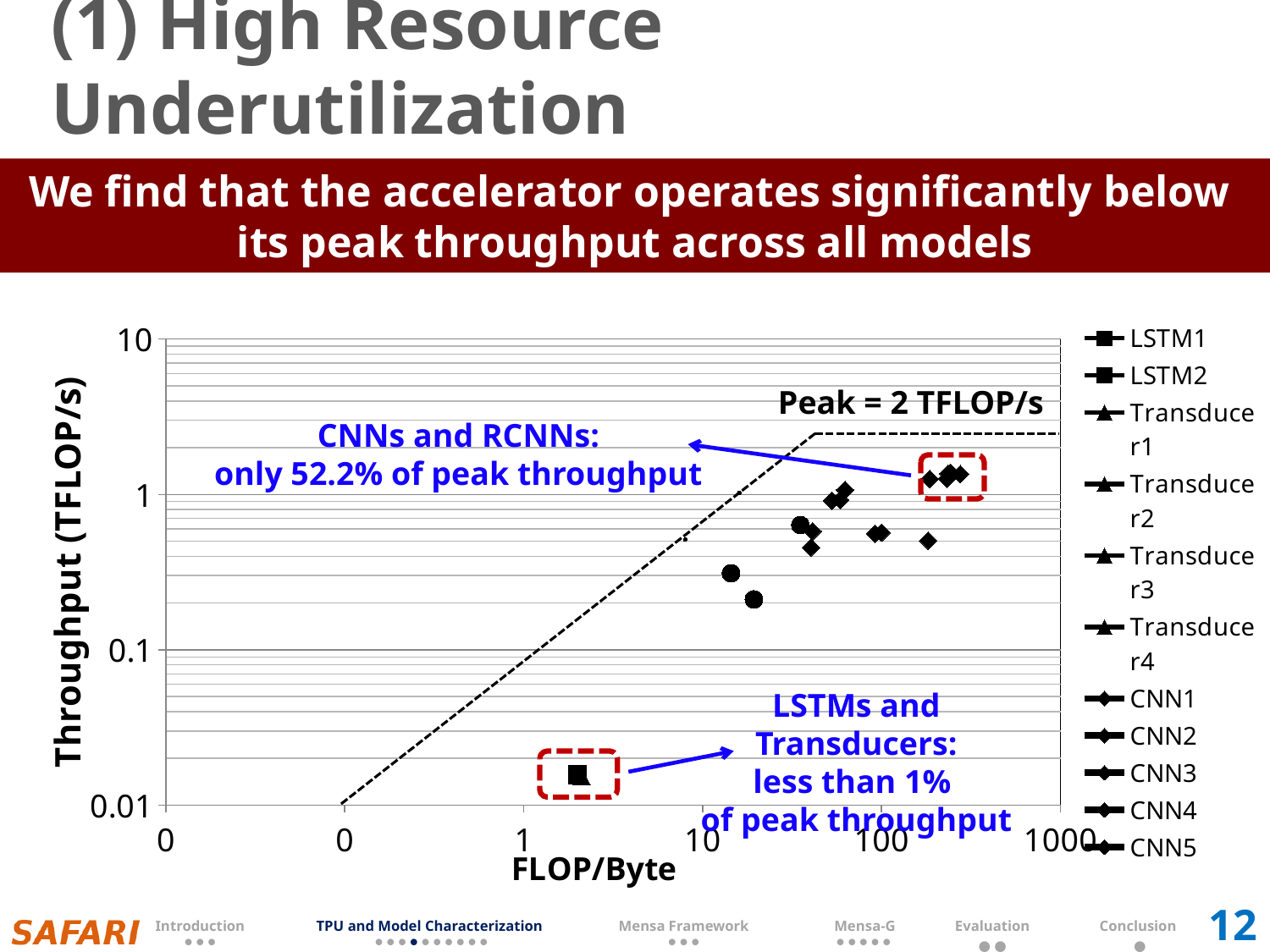
Is the throughput of the points inside the upper-right red dashed box greater or less than 1 TFLOP/s? greater What peak throughput value is annotated on the chart? 2 TFLOP/s How many LSTM series does the legend list? 2 Which has higher throughput: the points in the upper-right red dashed box or the point in the lower red dashed box? the points in the upper-right red dashed box According to the chart annotation, what share of peak throughput do LSTMs and Transducers achieve? less than 1% How many Transducer series does the legend list? 4 Is the throughput of the point inside the lower red dashed box greater or less than 0.1 TFLOP/s? less What is the title of the horizontal axis of the chart? FLOP/Byte According to the chart annotation, what percentage of peak throughput do CNNs and RCNNs achieve? 52.2% What is the title of the vertical axis of the chart? Throughput (TFLOP/s) How many CNN series does the legend list? 5 What kind of chart is shown on the slide? scatter chart